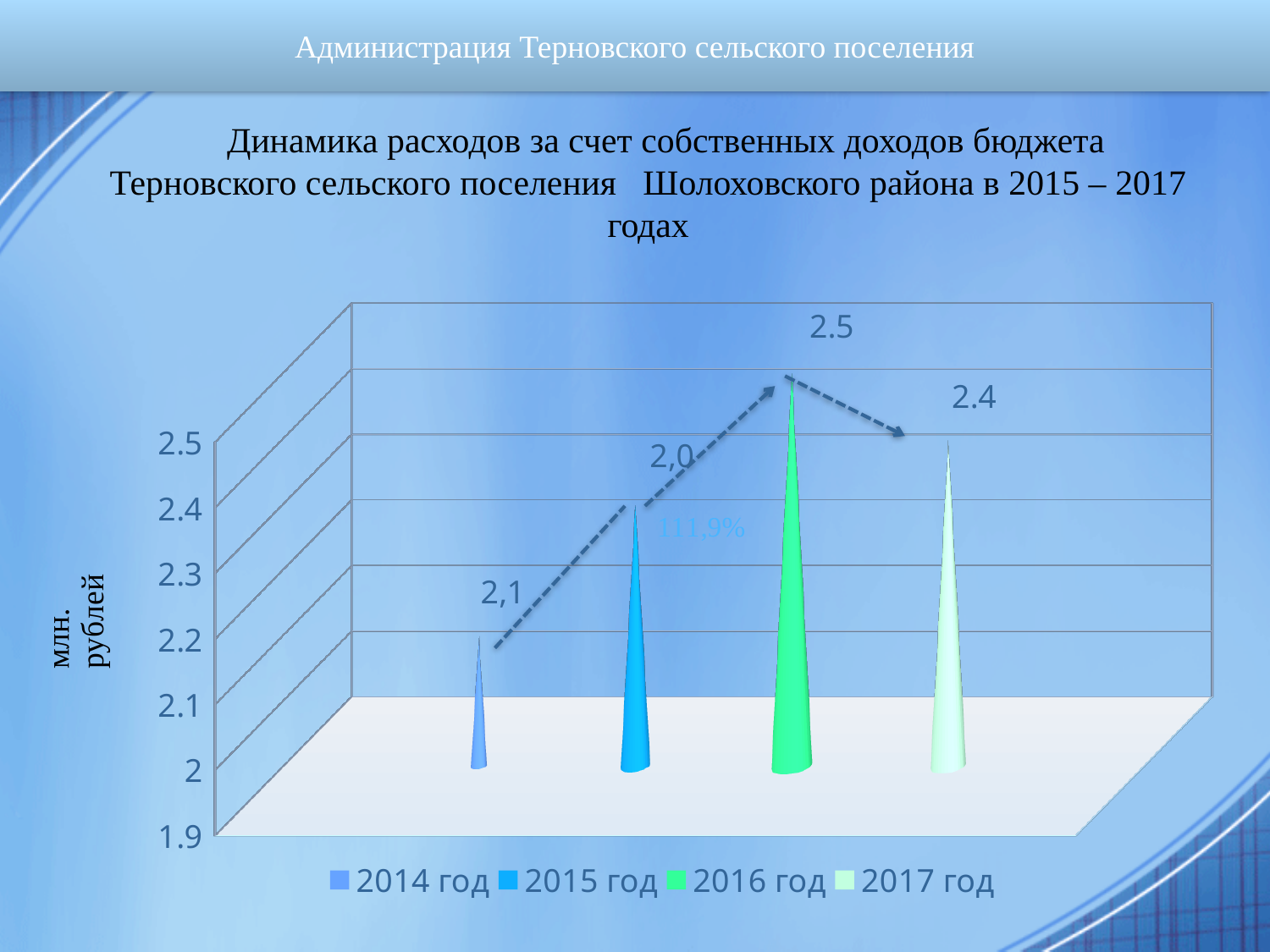
What is the value labelled for 2014 год? 2,1 How many bars are plotted on the chart? 4 How many series does the legend list? 4 What is the label on the vertical axis of the chart? млн. рублей Which year has the highest value on the chart? 2016 год What kind of chart is shown on the slide? bar chart What is the difference between the labelled values for 2016 год and 2017 год? 0.1 What is the value labelled for 2017 год? 2.4 What is the value labelled for 2016 год? 2.5 Which year has the lowest value on the chart? 2014 год Is the value for 2016 год greater or less than 2.3? greater Which is larger, the value for 2016 год or the value for 2017 год? 2016 год